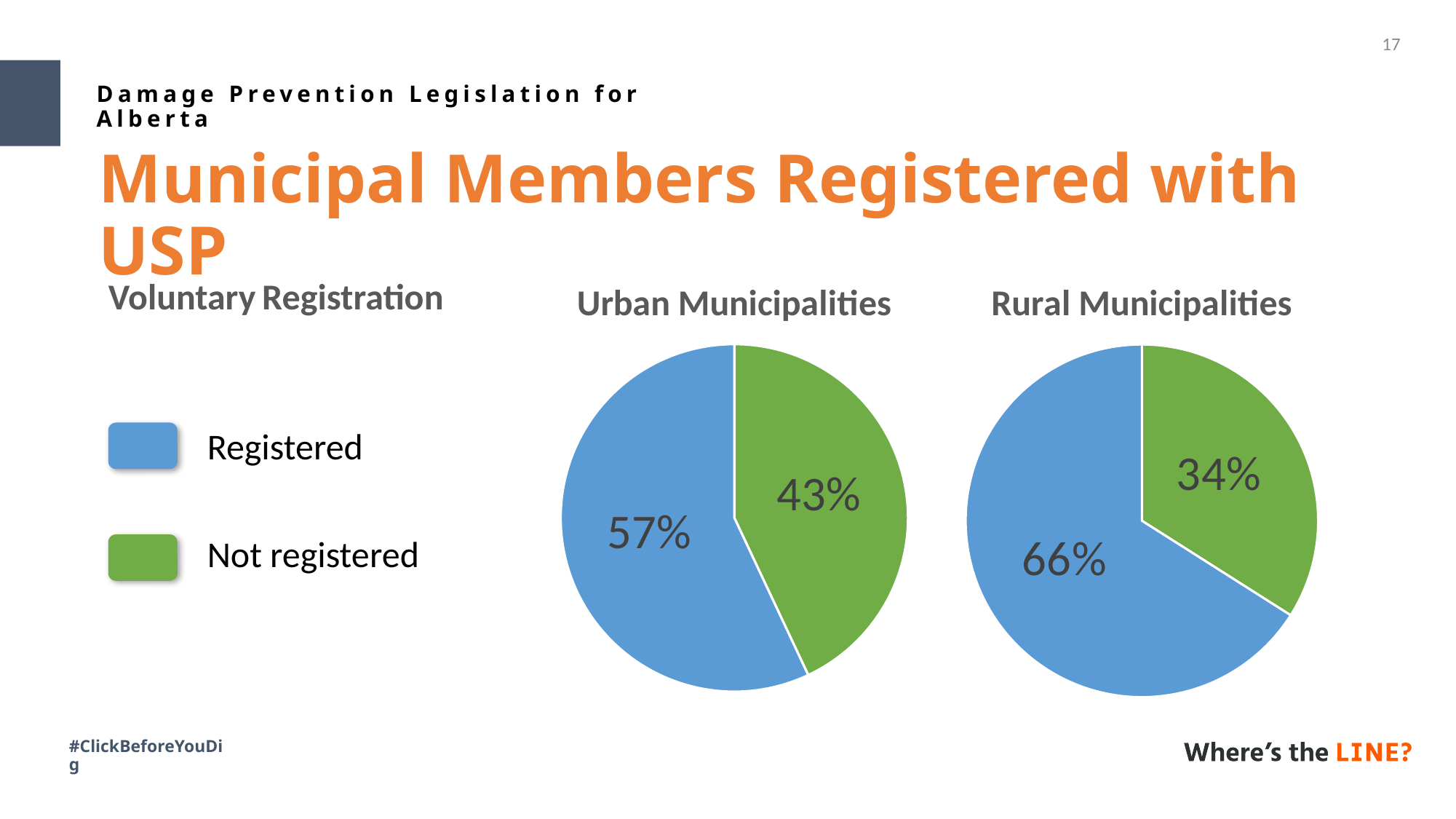
In the Urban Municipalities chart, what percentage of members are not registered? 43% In the Rural Municipalities chart, what percentage of members are registered? 66% In the Rural Municipalities chart, which category has the smallest share? Not registered Which chart shows a higher registered share, Urban Municipalities or Rural Municipalities? Rural Municipalities In the Urban Municipalities chart, what percentage of members are registered? 57% In the pie charts, which colour represents Not registered? Green In the Rural Municipalities chart, what percentage of members are not registered? 34% In the Urban Municipalities chart, which slice is larger, Registered or Not registered? Registered What type of chart is used for Urban Municipalities? Pie chart In the Rural Municipalities chart, what is the difference between the Registered and Not registered shares? 32% How many categories does the legend list for the pie charts? 2 In the Urban Municipalities chart, what is the difference between the Registered and Not registered shares? 14%